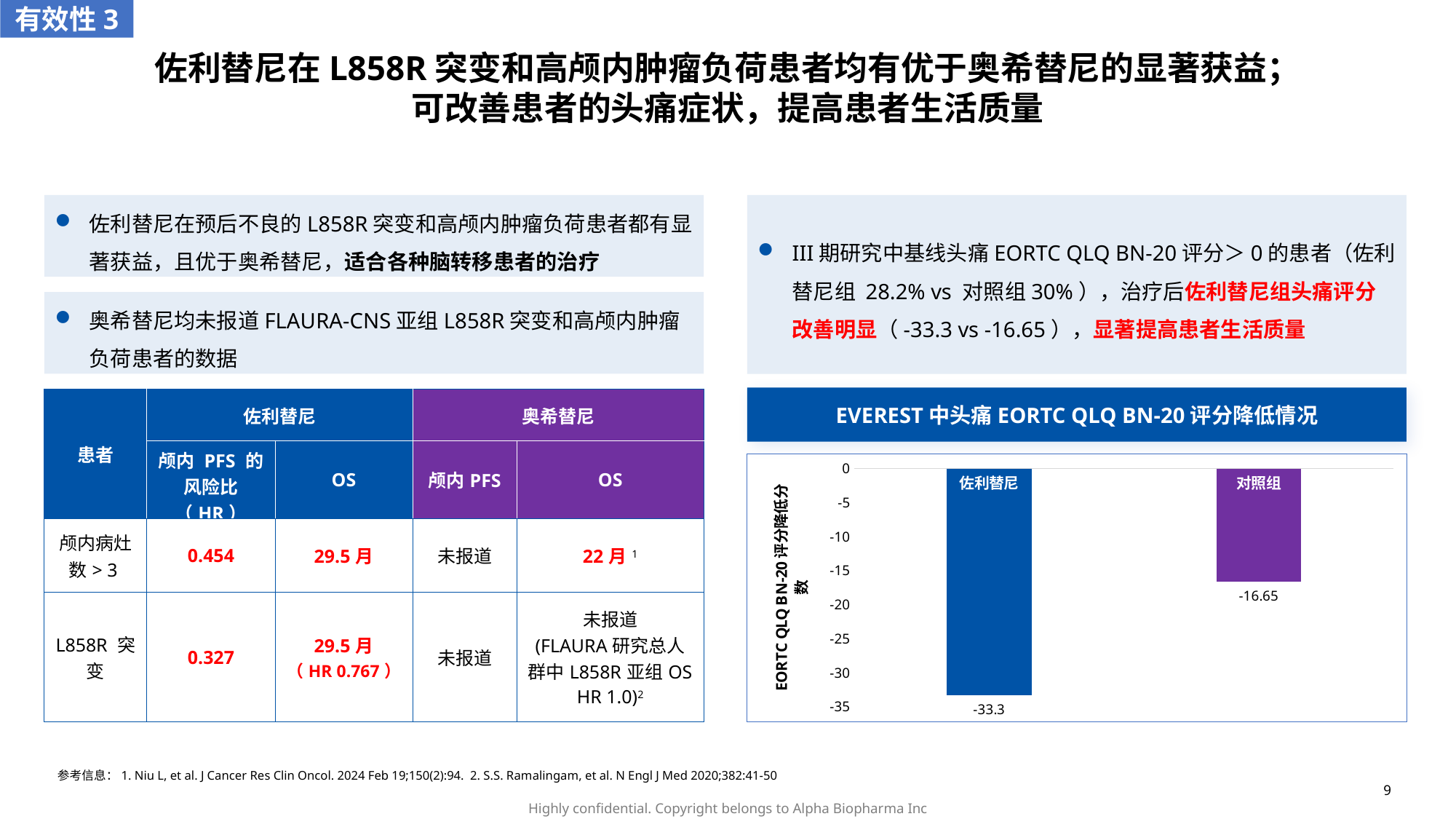
What is the value shown for 佐利替尼 in the chart? -33.3 What is the value shown for 对照组 in the chart? -16.65 What is the difference between the values for 佐利替尼 and 对照组 in the chart? 16.65 What type of chart is shown on the slide? Bar chart How many bars are plotted in the chart? 2 Is the value for 佐利替尼 greater or less than -30? less Which group has the lower (more negative) value in the chart? 佐利替尼 What is the lowest tick value shown on the chart's vertical axis? -35 Is the bar for 佐利替尼 larger in magnitude than the bar for 对照组? Yes Which group has the higher (less negative) value in the chart? 对照组 What is the title of the chart? EVEREST 中头痛 EORTC QLQ BN-20 评分降低情况 Is the value for 对照组 greater or less than -20? greater